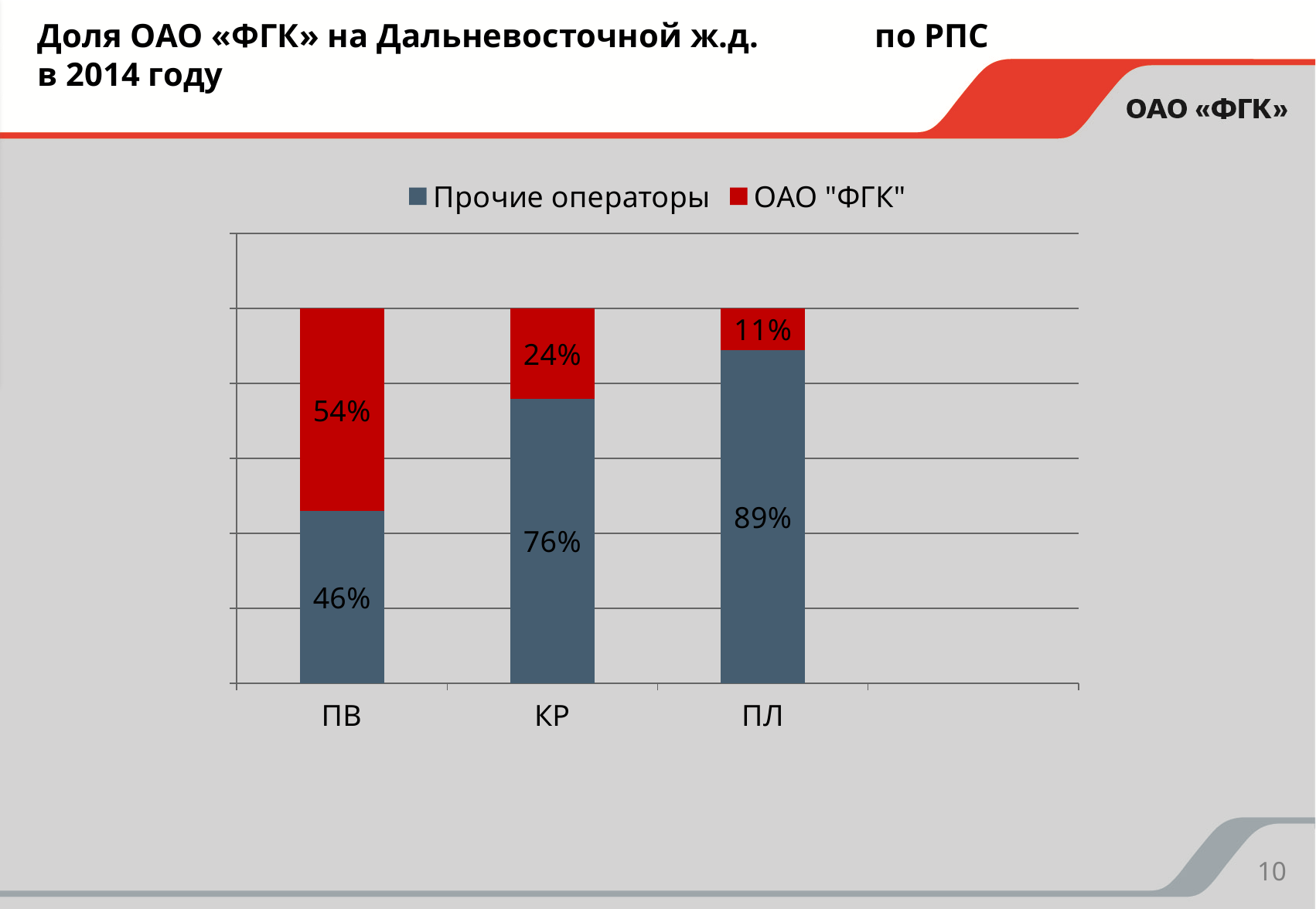
How many series does the legend list? 2 What is the total of the stacked bar for КР? 100% What is the value for ОАО "ФГК" in the ПЛ category? 11% What is the value for Прочие операторы in the ПЛ category? 89% What is the value for Прочие операторы in the КР category? 76% What is the value for ОАО "ФГК" in the ПВ category? 54% What is the difference between the ОАО "ФГК" values for ПВ and КР? 30% What kind of chart is shown on the slide? Stacked bar chart In which category is the ОАО "ФГК" share highest? ПВ Which is larger: the Прочие операторы value for ПВ or for КР? КР How many categories are shown on the x axis? 3 In which category is the ОАО "ФГК" share lowest? ПЛ